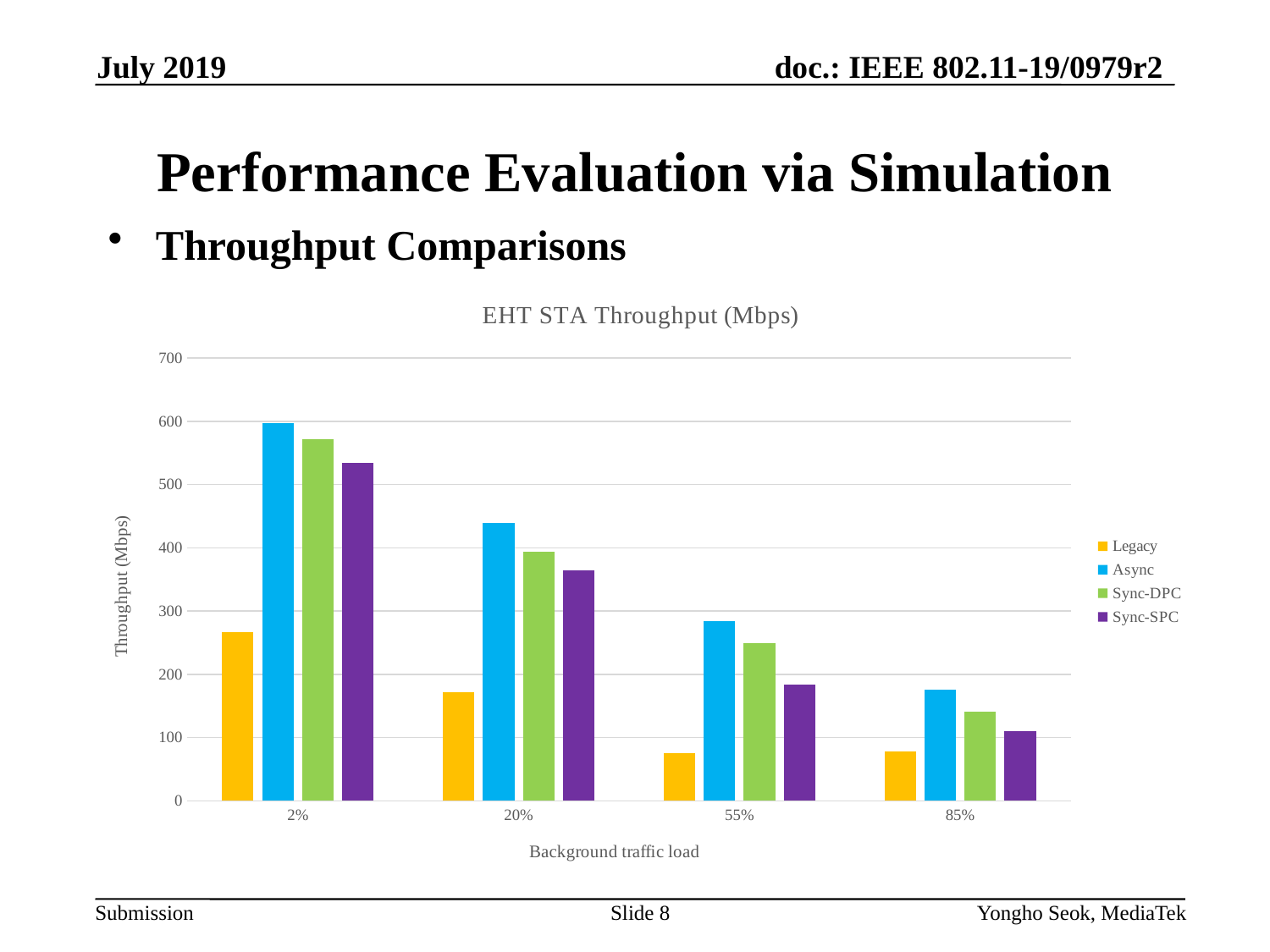
What is the title of the chart? EHT STA Throughput (Mbps) Is the Legacy value at 55% background traffic load greater or less than 100? less How many series does the legend list? 4 Do the Async throughput values rise or fall as the background traffic load increases along the x axis? fall Which series has the lowest throughput at 2% background traffic load? Legacy Is the Async value at 2% background traffic load greater or less than 500? greater At which background traffic load is the Async throughput highest? 2% What kind of chart is shown on the slide? bar chart What is the label of the x axis? Background traffic load How many background traffic load categories are shown on the x axis? 4 At 20% background traffic load, which is larger: Async or Sync-DPC? Async Is the Sync-SPC value at 85% background traffic load greater or less than 200? less